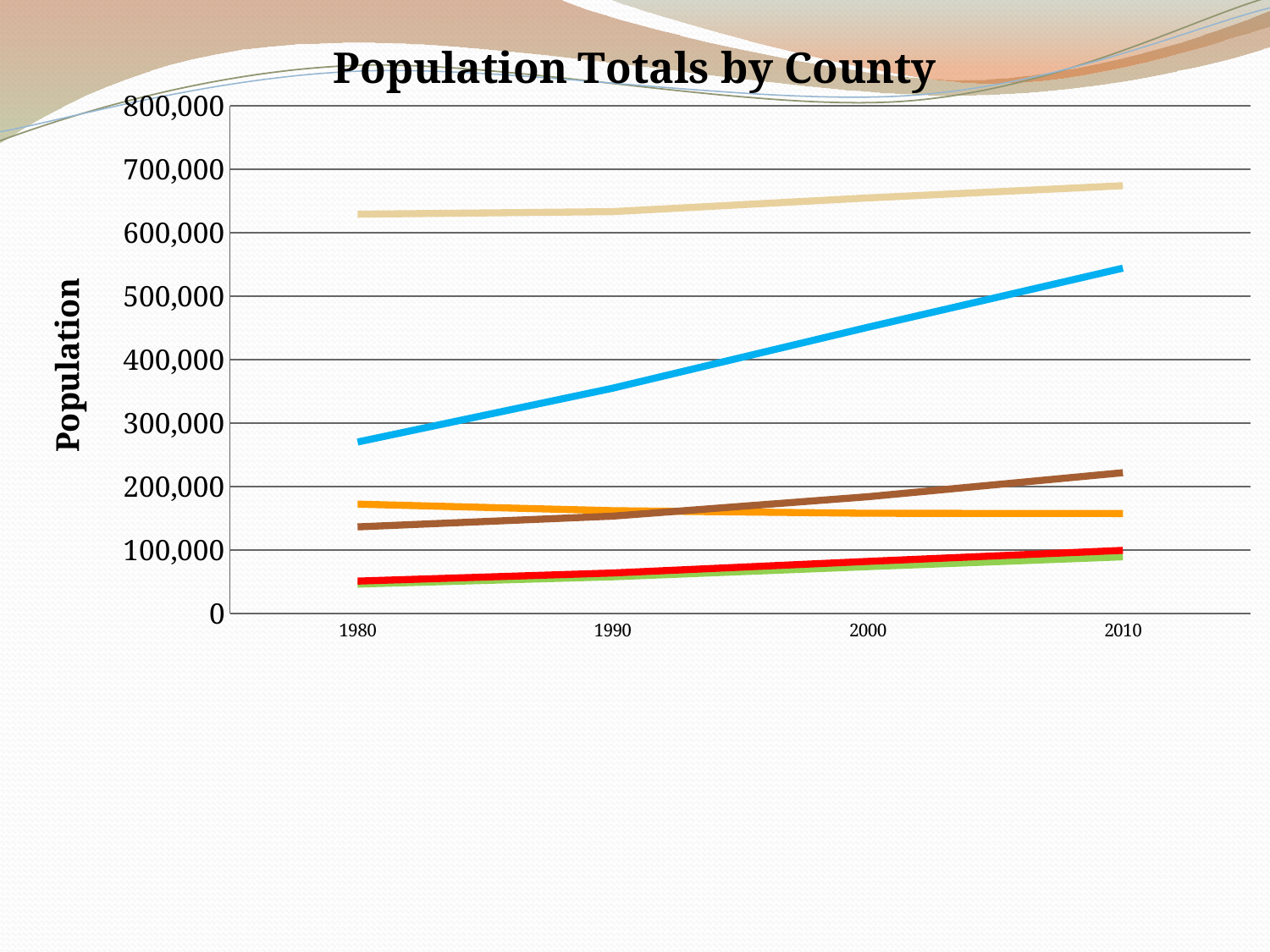
Is the value of the tan line in 1980 greater or less than 600,000? greater How many years are marked along the x axis of the chart? 4 Which line has the highest value in 2010? the tan line Does the blue line rise or fall from 1980 to 2010? rise What is the title of the chart? Population Totals by County In 1980, which is higher, the orange line or the brown line? the orange line What kind of chart is shown on the slide? line chart Is the value of the red line in 1980 greater or less than 100,000? less Does the orange line rise or fall from 1980 to 2010? fall Is the value of the blue line in 2010 greater or less than 500,000? greater How many lines are plotted on the chart? 6 What is the label on the vertical axis of the chart? Population